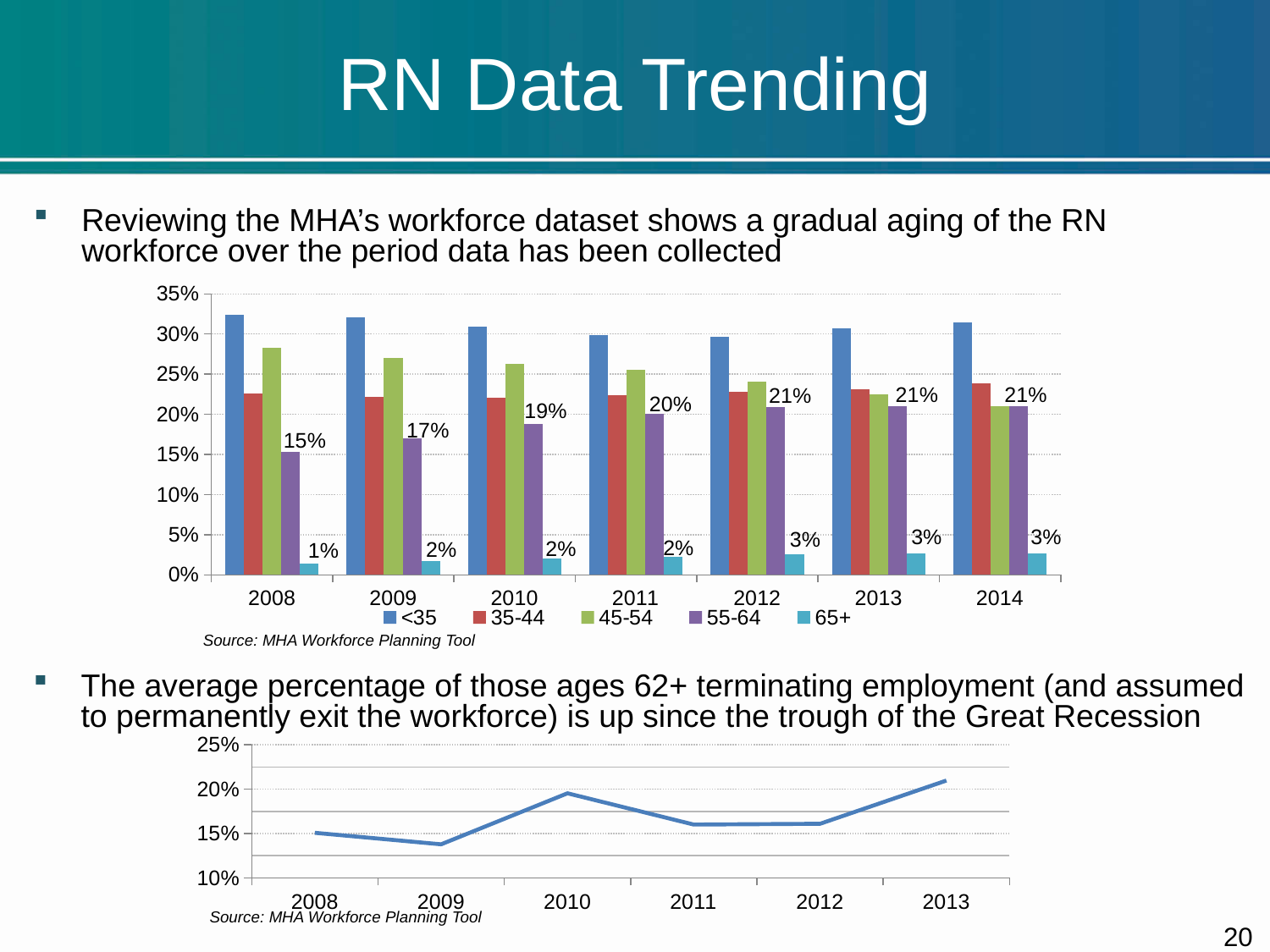
In the top bar chart, by how many percentage points did the 55-64 share change from 2008 to 2014? 6 percentage points In the top bar chart, is the value for the <35 age group in 2008 greater or less than 30%? greater What kind of chart is the bottom chart on the slide? line chart In the top bar chart, what is the value for the 55-64 age group in 2008? 15% In the top bar chart, how many series does the legend list? 5 In the bottom line chart, which year has the lowest value? 2009 In the top bar chart, which year has the lowest value for the 65+ age group? 2008 In the top bar chart, what is the value for the 65+ age group in 2014? 3% In the top bar chart, what is the value for the 55-64 age group in 2011? 20% In the bottom line chart, which year has the highest value? 2013 In the bottom line chart, is the value for 2010 greater or less than 15%? greater In the top bar chart, does the 55-64 share rise or fall from 2008 to 2014? rise